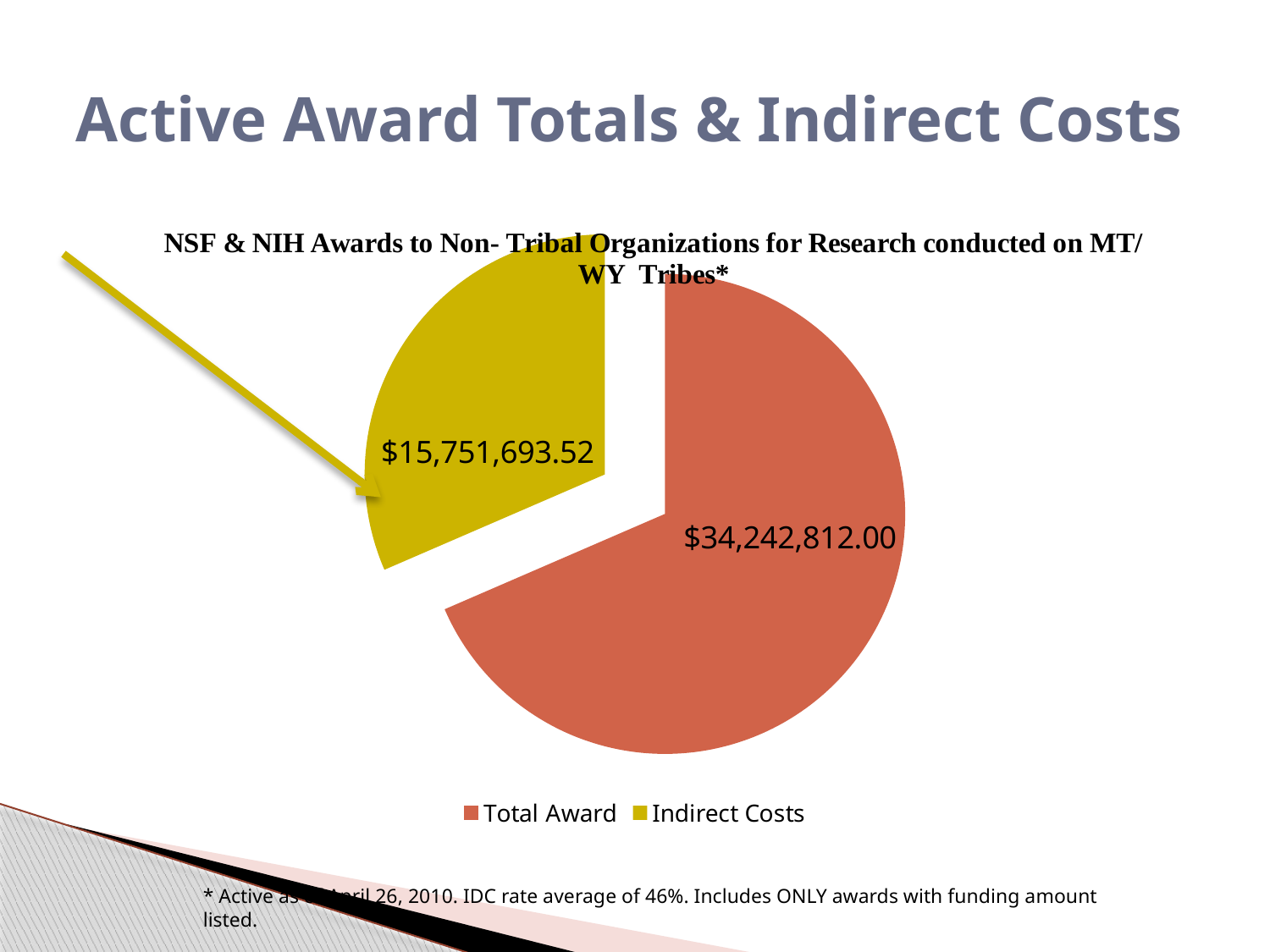
What is the title of the pie chart? NSF & NIH Awards to Non- Tribal Organizations for Research conducted on MT/ WY Tribes* What is the difference between the Total Award value and the Indirect Costs value? $18,491,118.48 How many entries does the legend list? 2 What colour is the Indirect Costs slice? Yellow How many slices does the pie chart have? 2 What is the value shown for Indirect Costs? $15,751,693.52 What is the sum of the two values shown in the pie chart? $49,994,505.52 What type of chart is shown on the slide? Pie chart Which slice of the pie is the largest? Total Award What is the value shown for Total Award? $34,242,812.00 Which is larger, Total Award or Indirect Costs? Total Award Which slice of the pie is the smallest? Indirect Costs